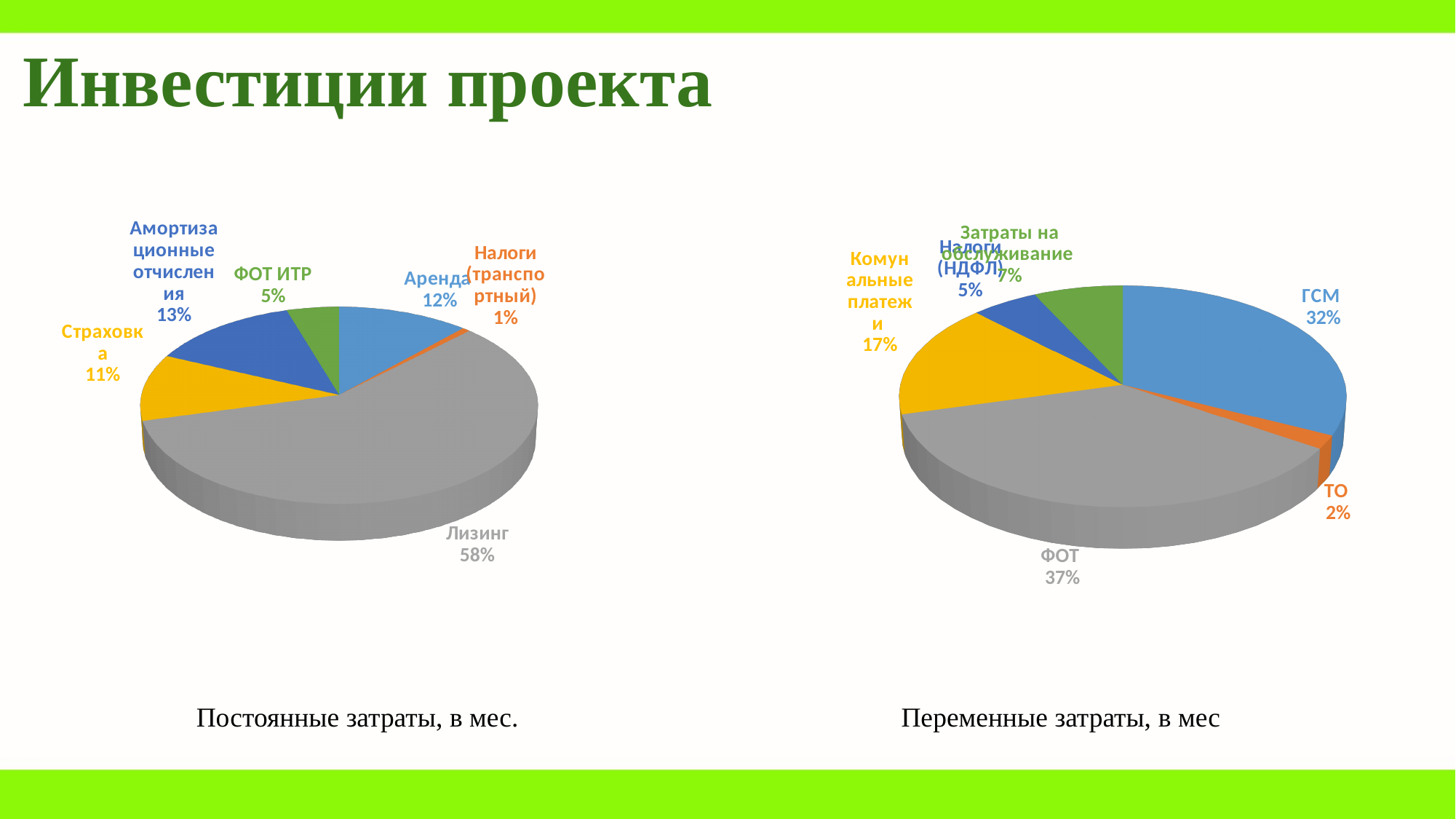
In the right chart (Переменные затраты, в мес), what share does ГСМ have? 32% In the left chart (Постоянные затраты, в мес.), which category has the smallest share? Налоги (транспортный) In the right chart (Переменные затраты, в мес), what is the difference in percentage points between ФОТ and ГСМ? 5 In the left chart (Постоянные затраты, в мес.), what share does Амортизационные отчисления have? 13% In the left chart (Постоянные затраты, в мес.), what share does Лизинг have? 58% In the right chart (Переменные затраты, в мес), which category has the largest share? ФОТ In the right chart (Переменные затраты, в мес), which is larger, Затраты на обслуживание or Налоги (НДФЛ)? Затраты на обслуживание In the left chart (Постоянные затраты, в мес.), how many slices does the pie have? 6 In the left chart (Постоянные затраты, в мес.), what is the difference in percentage points between Аренда and Страховка? 1 What type of chart is used for the right chart (Переменные затраты, в мес)? Pie chart In the right chart (Переменные затраты, в мес), what share does Комунальные платежи have? 17% In the left chart (Постоянные затраты, в мес.), which is larger, ФОТ ИТР or Страховка? Страховка